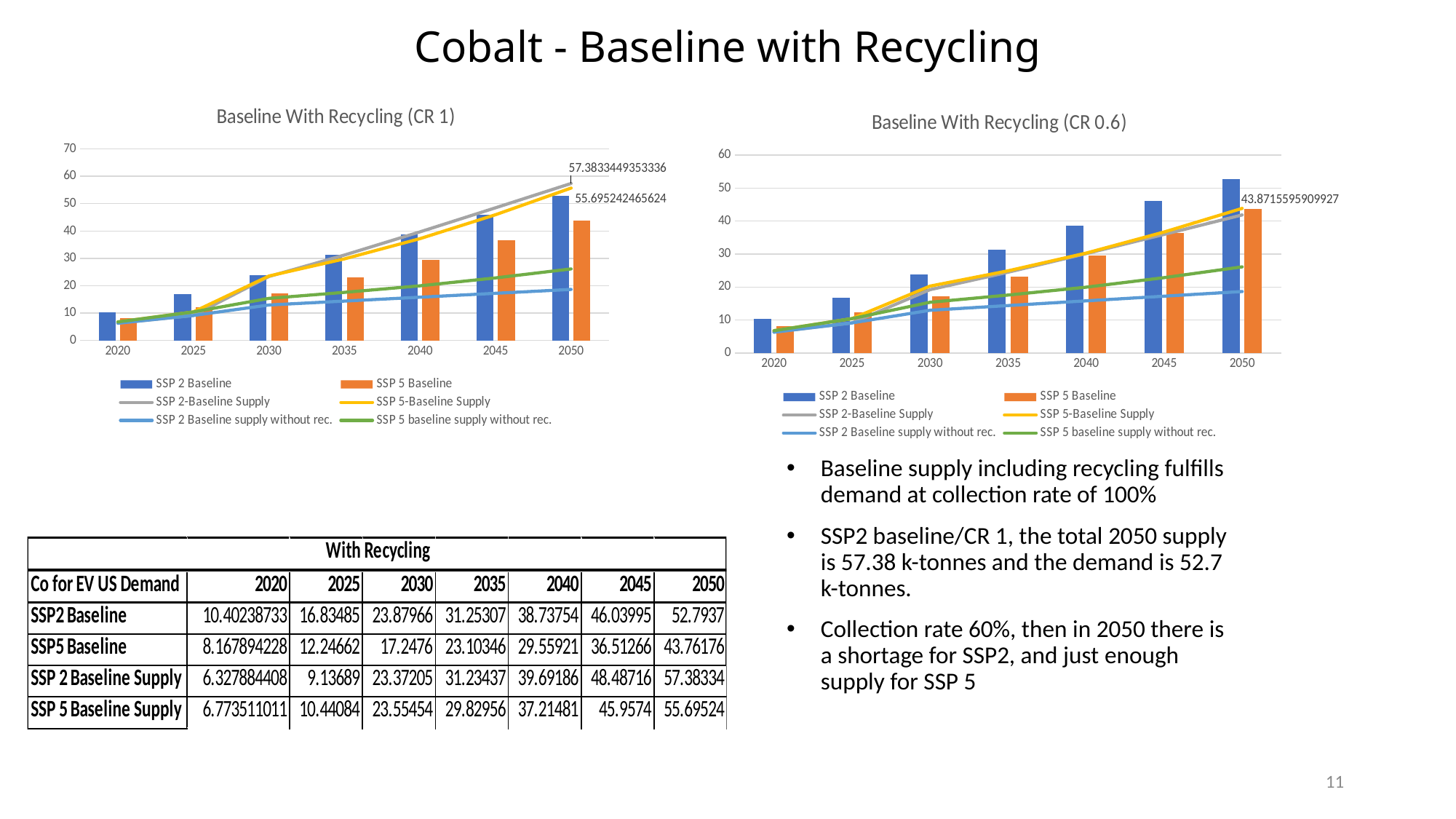
On the 'Baseline With Recycling (CR 1)' chart, what is the difference between the two printed 2050 data labels (57.3833449353336 and 55.695242465624)? 1.6881024697096 What kind of chart is 'Baseline With Recycling (CR 1)'? A combined bar and line chart On the 'Baseline With Recycling (CR 1)' chart, is the SSP 2 Baseline bar for 2050 greater or less than 50? greater On the 'Baseline With Recycling (CR 1)' chart, how many series does the legend list? 6 On the 'Baseline With Recycling (CR 0.6)' chart, what value is printed as the data label at 2050? 43.8715595909927 On the 'Baseline With Recycling (CR 0.6)' chart, do the SSP 2 Baseline bars rise or fall from 2020 to 2050? rise On the 'Baseline With Recycling (CR 0.6)' chart, is the SSP 5 Baseline bar for 2045 greater or less than 40? less On the 'Baseline With Recycling (CR 0.6)' chart, which year has the tallest SSP 2 Baseline bar? 2050 On the 'Baseline With Recycling (CR 0.6)' chart, how many years are shown on the x axis? 7 On the 'Baseline With Recycling (CR 1)' chart, what value is printed as the data label for SSP 2-Baseline Supply at 2050? 57.3833449353336 On the 'Baseline With Recycling (CR 1)' chart, what value is printed as the data label for SSP 5-Baseline Supply at 2050? 55.695242465624 On the 'Baseline With Recycling (CR 1)' chart, which is larger at 2050: the SSP 2 Baseline bar or the SSP 5 Baseline bar? SSP 2 Baseline